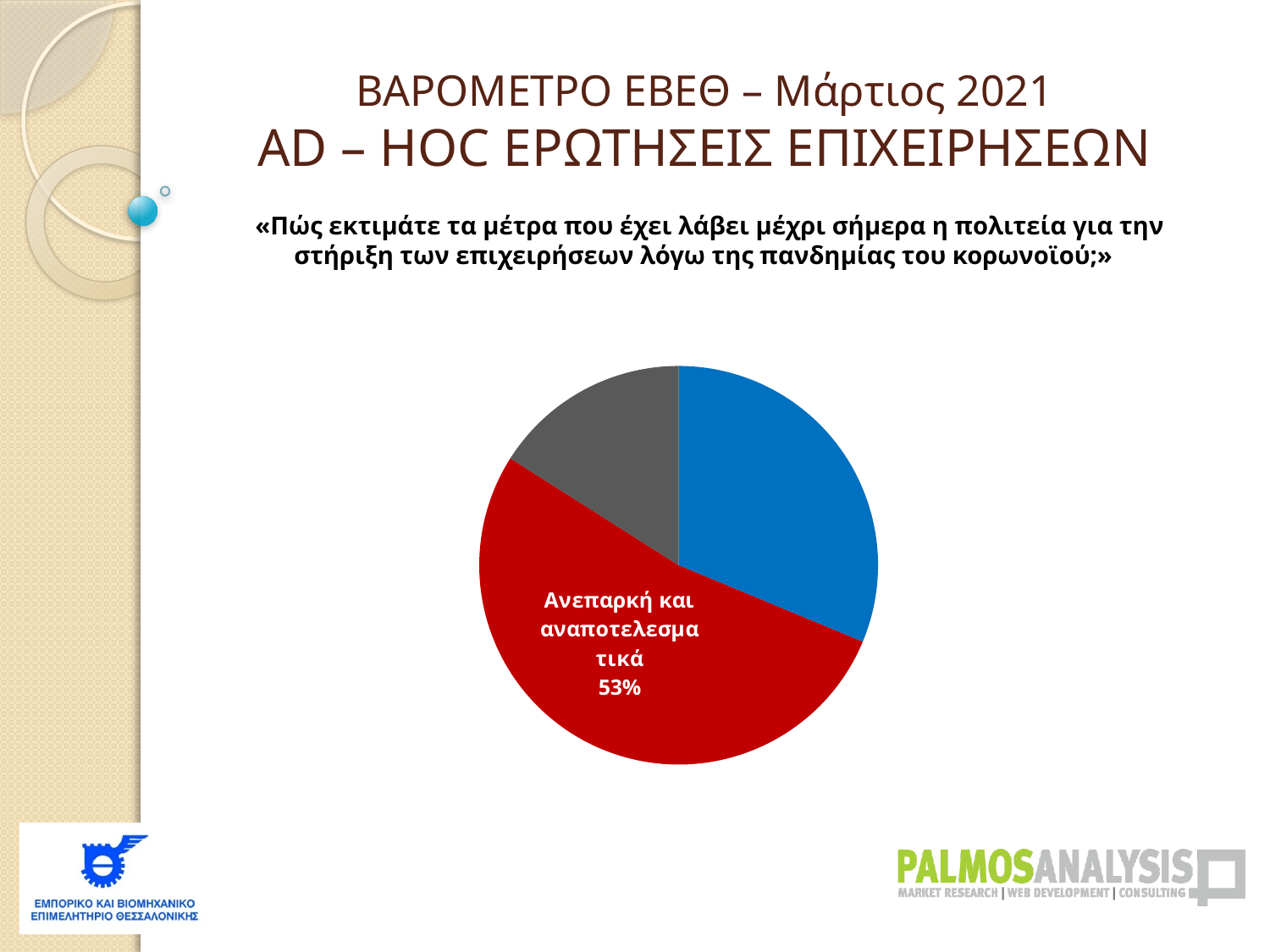
Which slice of the pie chart is the largest? Ανεπαρκή και αναποτελεσματικά Which colour slice of the pie chart is the smallest? grey What share of the pie does the "Ανεπαρκή και αναποτελεσματικά" slice represent? 53% How many slices does the pie chart have? 3 Which is larger: the red slice or the blue slice? the red slice What percentage of respondents answered "Ανεπαρκή και αναποτελεσματικά"? 53% What kind of chart is shown on the slide? pie chart Which is larger: the blue slice or the grey slice? the blue slice What colour is the slice labelled "Ανεπαρκή και αναποτελεσματικά"? red Does the pie chart have a legend? No